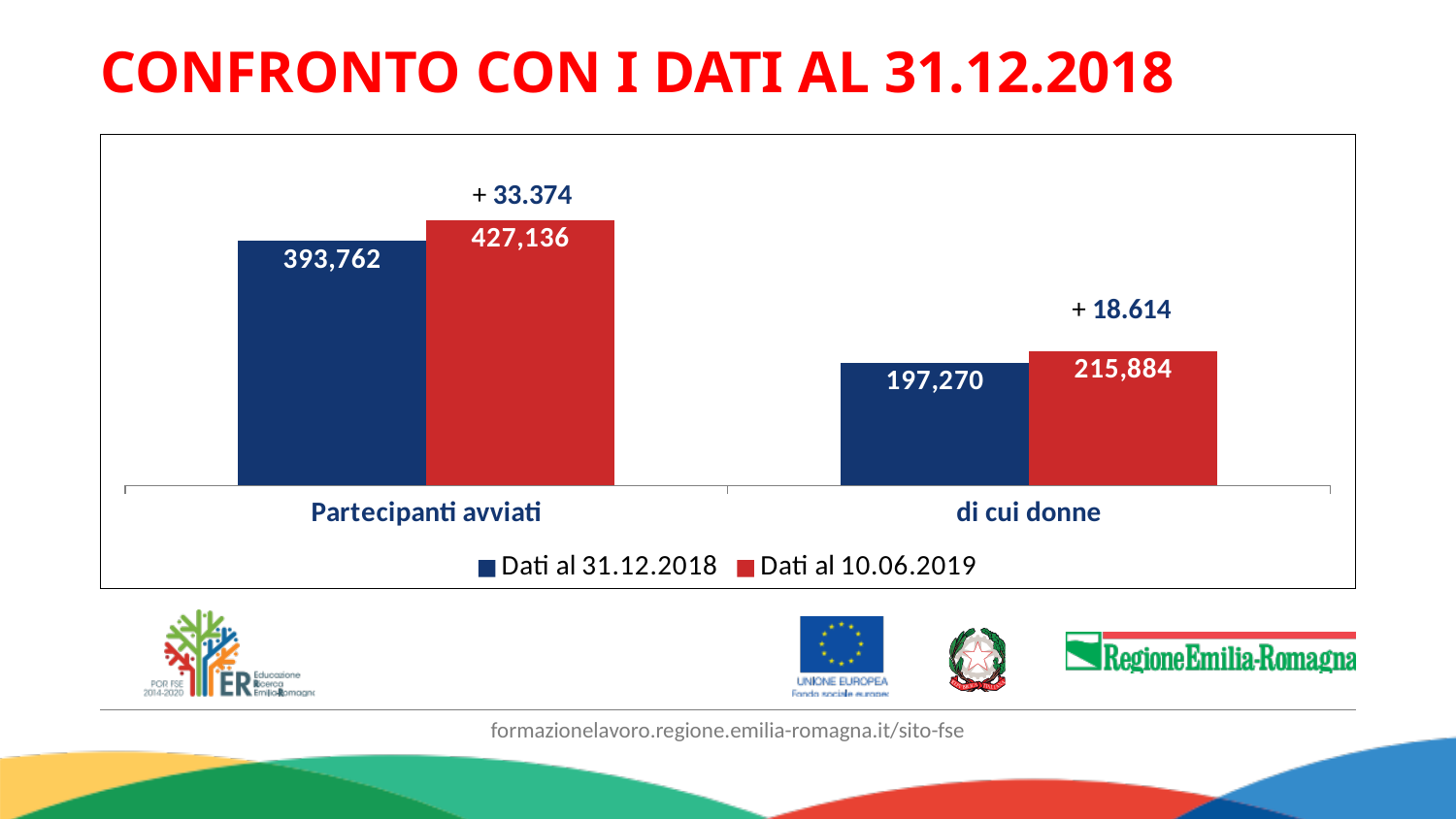
How many series does the legend list? 2 What is the value for di cui donne in the Dati al 10.06.2019 series? 215,884 What is the value for Partecipanti avviati in the Dati al 31.12.2018 series? 393,762 Which series has the larger value for di cui donne, Dati al 31.12.2018 or Dati al 10.06.2019? Dati al 10.06.2019 What is the difference between the Dati al 10.06.2019 and Dati al 31.12.2018 values for Partecipanti avviati? 33,374 Which category has the highest value in the Dati al 10.06.2019 series? Partecipanti avviati Which category has the lowest value in the Dati al 31.12.2018 series? di cui donne What is the value for di cui donne in the Dati al 31.12.2018 series? 197,270 What is the difference between the Dati al 10.06.2019 and Dati al 31.12.2018 values for di cui donne? 18,614 What kind of chart is shown on the slide? Bar chart What is the value for Partecipanti avviati in the Dati al 10.06.2019 series? 427,136 How many categories are shown on the x axis? 2